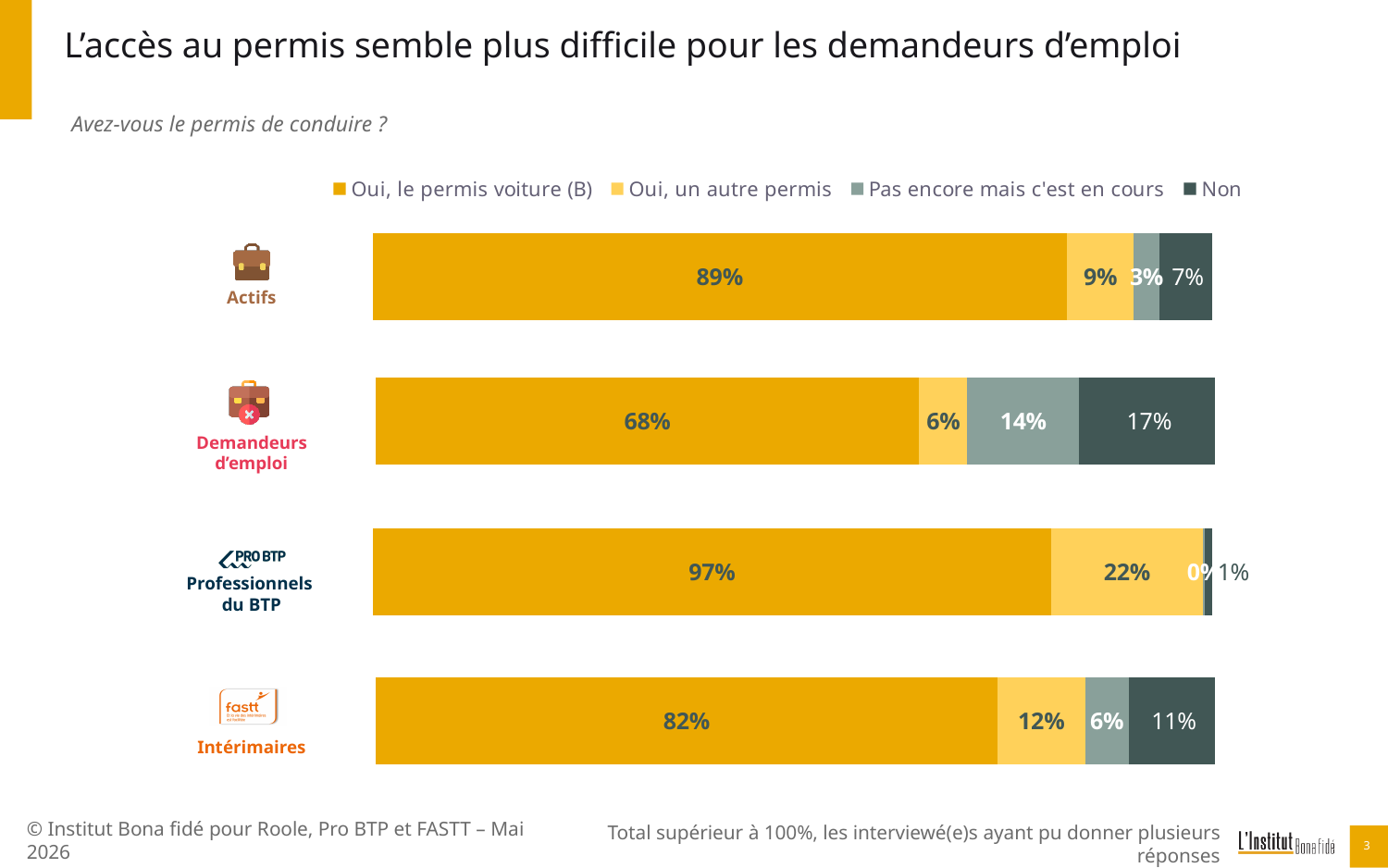
How many series does the legend list? 4 What is the difference between the "Oui, le permis voiture (B)" share for Actifs and for Demandeurs d'emploi? 21 percentage points What percentage of Actifs answered "Pas encore mais c'est en cours"? 3% How many groups are shown in the chart? 4 What kind of chart is shown on the slide? Stacked bar chart What percentage of Professionnels du BTP answered "Oui, un autre permis"? 22% Which group has the highest share answering "Non"? Demandeurs d'emploi Which is larger: the "Non" share for Actifs or for Intérimaires? Intérimaires Which group has the lowest share answering "Oui, le permis voiture (B)"? Demandeurs d'emploi What percentage of Intérimaires answered "Non"? 11% What percentage of Demandeurs d'emploi answered "Oui, le permis voiture (B)"? 68% Which group has the highest share answering "Oui, le permis voiture (B)"? Professionnels du BTP